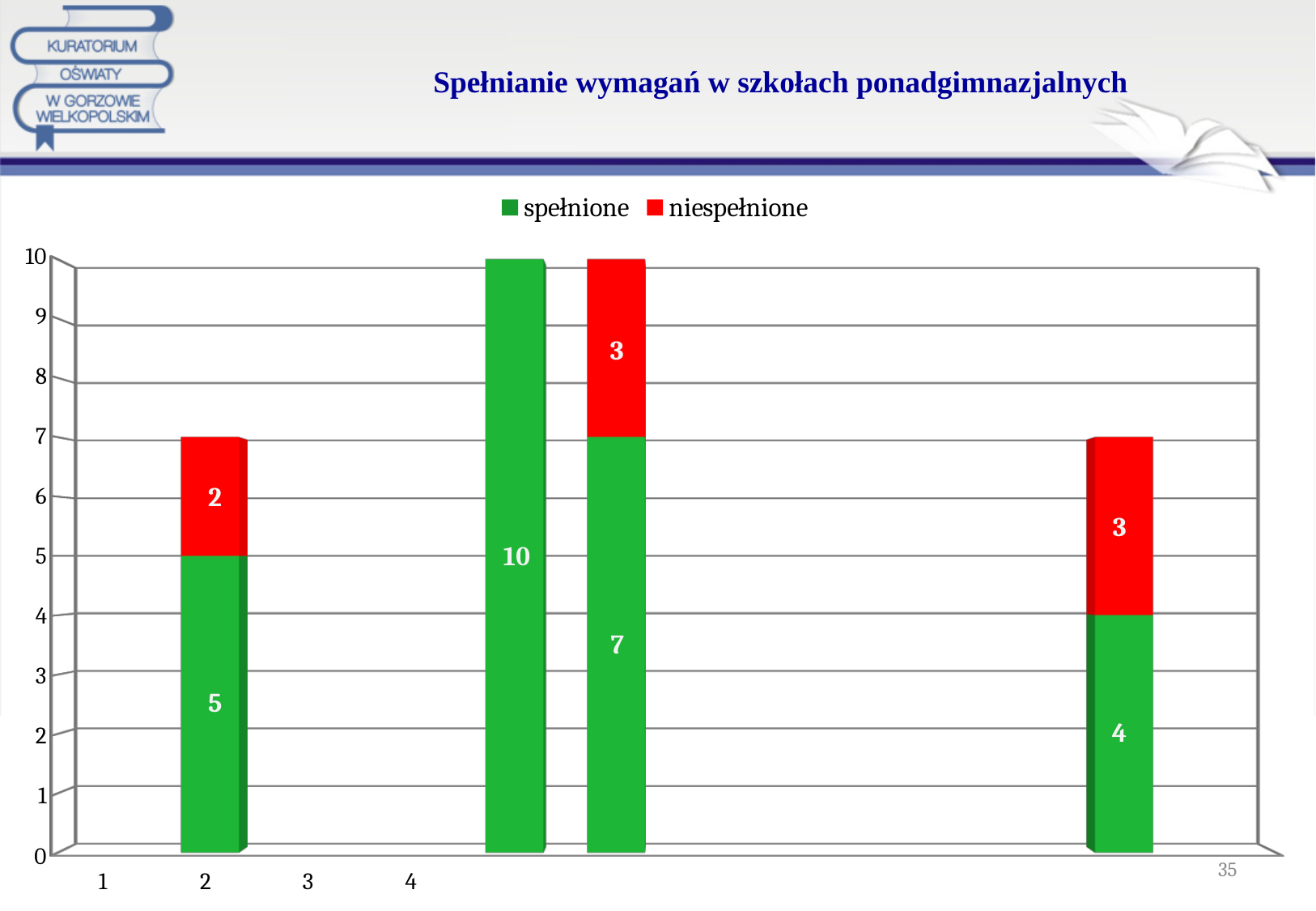
How many series does the legend list? 2 What is the 'spełnione' value for the second bar from the left? 10 What is the 'niespełnione' value for the first bar from the left? 2 What is the 'spełnione' value for the first bar from the left? 5 What is the 'spełnione' value for the fourth bar from the left? 4 What is the total of the stacked third bar from the left? 10 Which colour represents 'niespełnione' in the legend? red What kind of chart is shown on the slide? stacked bar chart Which bar has the highest 'spełnione' value? the second bar from the left What is the 'niespełnione' value for the third bar from the left? 3 How many bars are plotted in the chart? 4 What is the difference between the 'spełnione' and 'niespełnione' values in the fourth bar from the left? 1